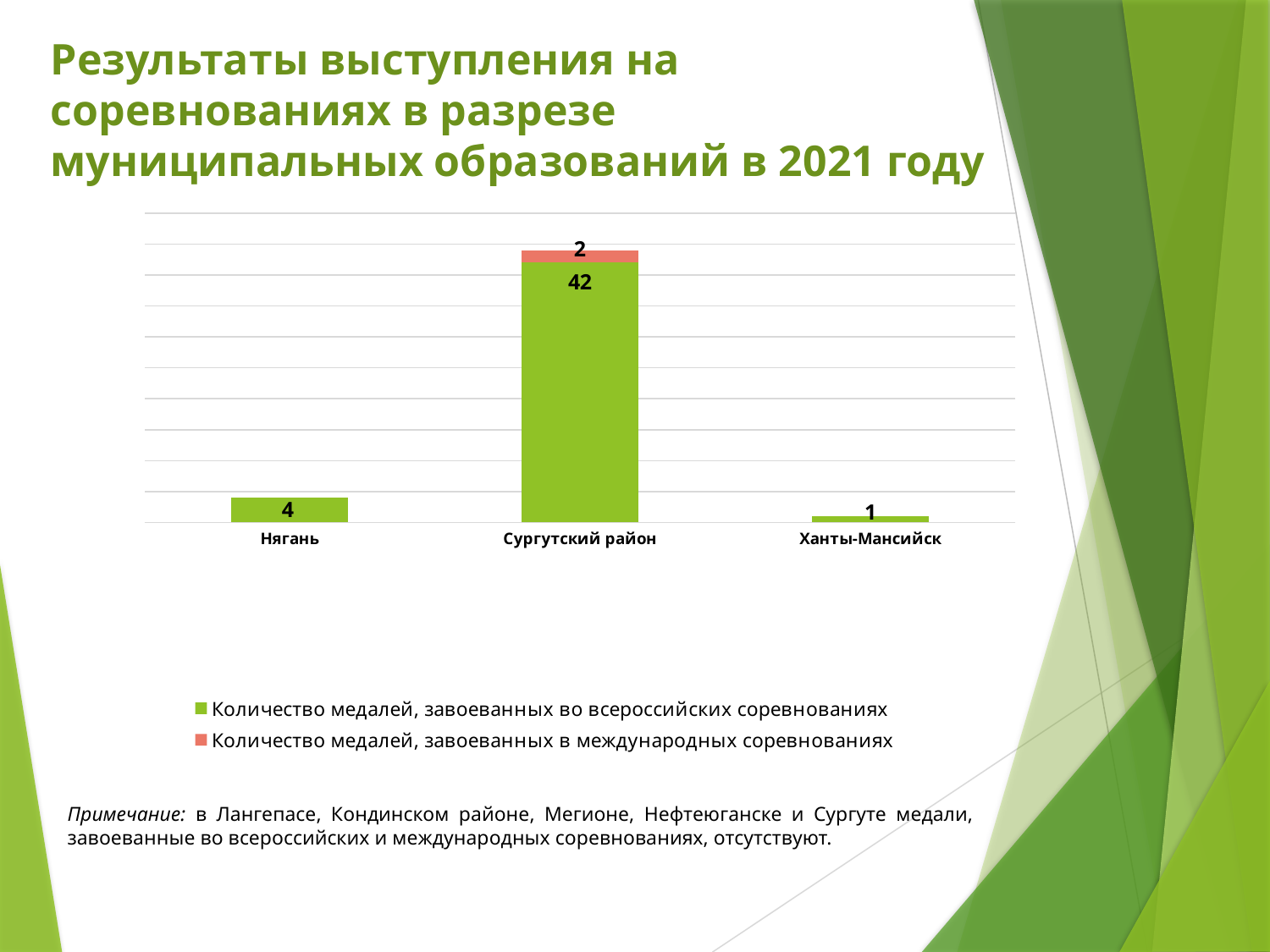
How many series does the chart's legend list? 2 Which municipality has the lowest number of medals won in all-Russian competitions? Ханты-Мансийск How many medals won in international competitions (Количество медалей, завоеванных в международных соревнованиях) are shown for Сургутский район? 2 How many municipalities (categories) are shown on the x axis of the chart? 3 Which municipality has the highest number of medals won in all-Russian competitions? Сургутский район What is the total number of medals shown in the stacked bar for Сургутский район? 44 How many medals won in all-Russian competitions (Количество медалей, завоеванных во всероссийских соревнованиях) are shown for Нягань? 4 Which has more medals won in all-Russian competitions, Нягань or Ханты-Мансийск? Нягань How many medals won in all-Russian competitions are shown for Ханты-Мансийск? 1 What is the difference between the all-Russian medals for Сургутский район and for Нягань? 38 How many medals won in all-Russian competitions are shown for Сургутский район? 42 What kind of chart is shown on the slide? bar chart